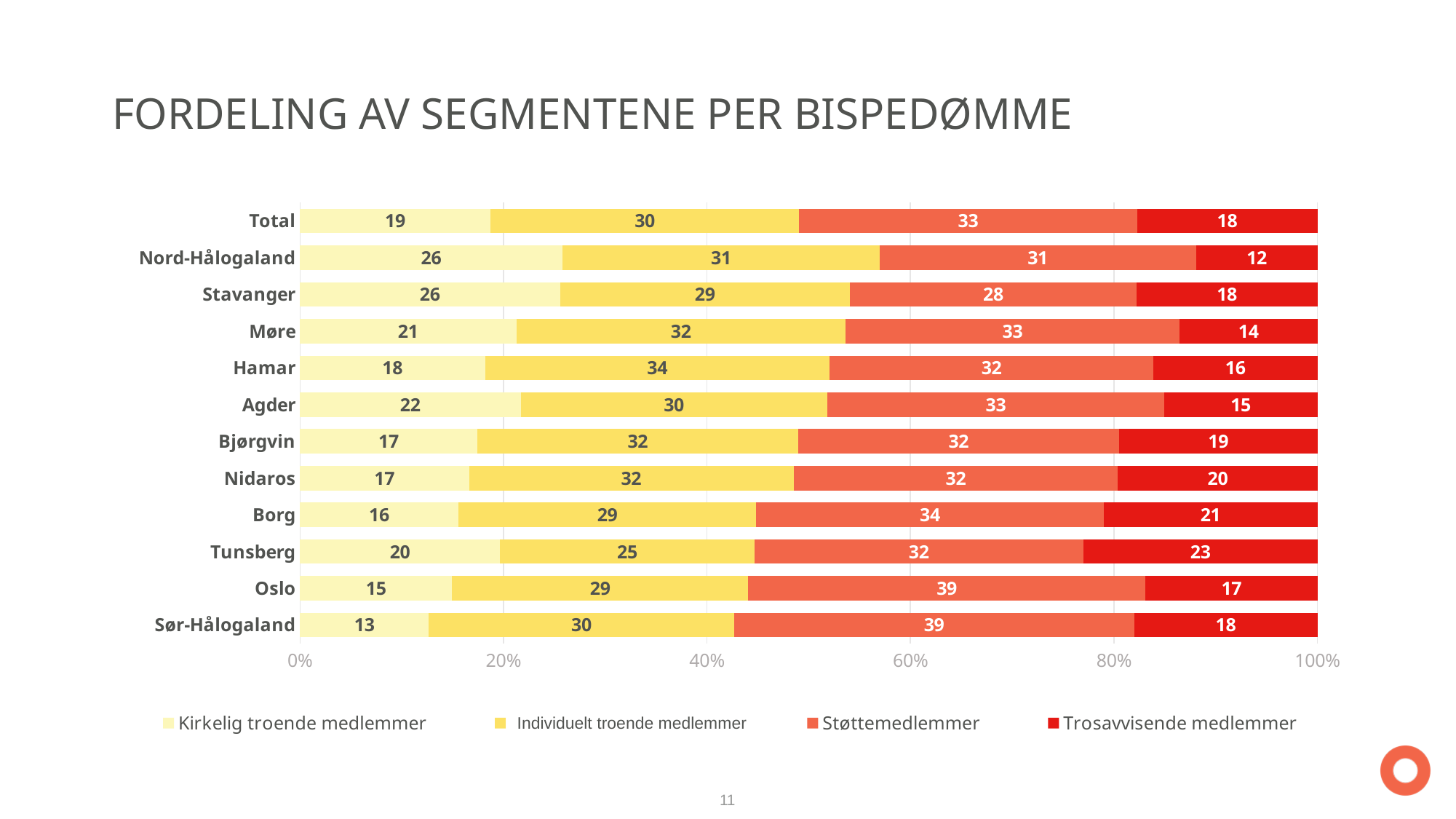
What is the value for Trosavvisende medlemmer in Nord-Hålogaland? 12 What is the value for Individuelt troende medlemmer in Hamar? 34 How many series does the legend list? 4 Which has a larger value for Kirkelig troende medlemmer, Borg or Agder? Agder What kind of chart is shown on the slide? Stacked bar chart What is the value for Støttemedlemmer in Oslo? 39 Which category has the lowest value for Kirkelig troende medlemmer? Sør-Hålogaland What is the total of the stacked bar for Total? 100 What is the title of the chart? FORDELING AV SEGMENTENE PER BISPEDØMME How many categories are shown on the y axis? 12 What is the difference between the Trosavvisende medlemmer values for Tunsberg and Nord-Hålogaland? 11 Which category has the highest value for Trosavvisende medlemmer? Tunsberg